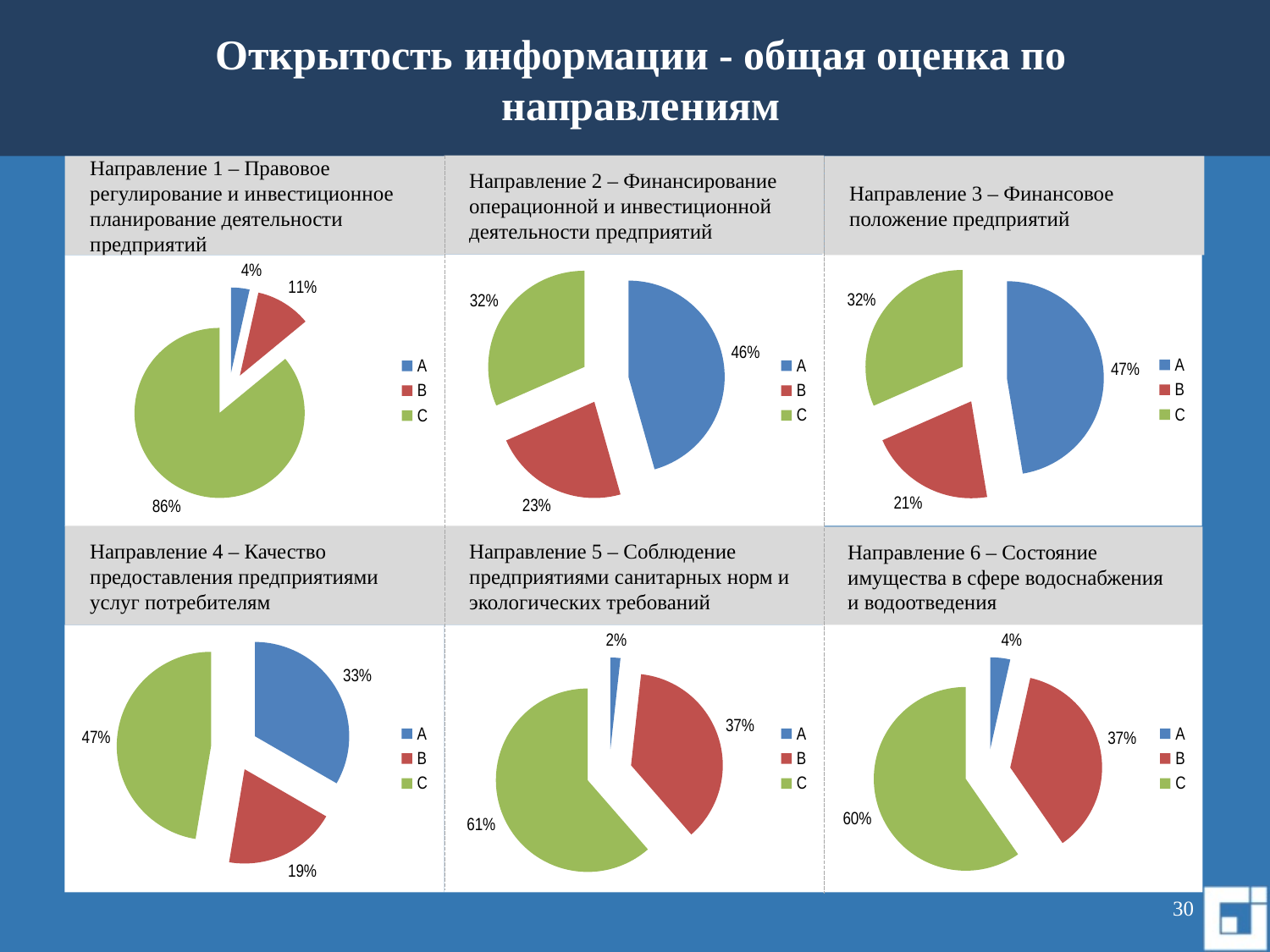
In the pie chart for Направление 5 (bottom middle), what is the share for A? 2% How many series does the legend of the Направление 6 chart (bottom right) list? 3 In the pie chart for Направление 1 (top left), what is the share for A? 4% In the pie chart for Направление 2 (top middle), what is the share for B? 23% In the pie chart for Направление 4 (bottom left), which is larger, the share of A or the share of B? A In the pie chart for Направление 3 (top right), what is the share for A? 47% In the pie chart for Направление 4 (bottom left), what is the difference between the shares of C and A? 14% In the pie chart for Направление 1 (top left), what is the share for C? 86% In the pie chart for Направление 3 (top right), which category has the smallest share? B In the pie chart for Направление 6 (bottom right), what is the share for C? 60% In the pie chart for Направление 2 (top middle), which category has the largest share? A How many pie charts are shown on the slide? 6